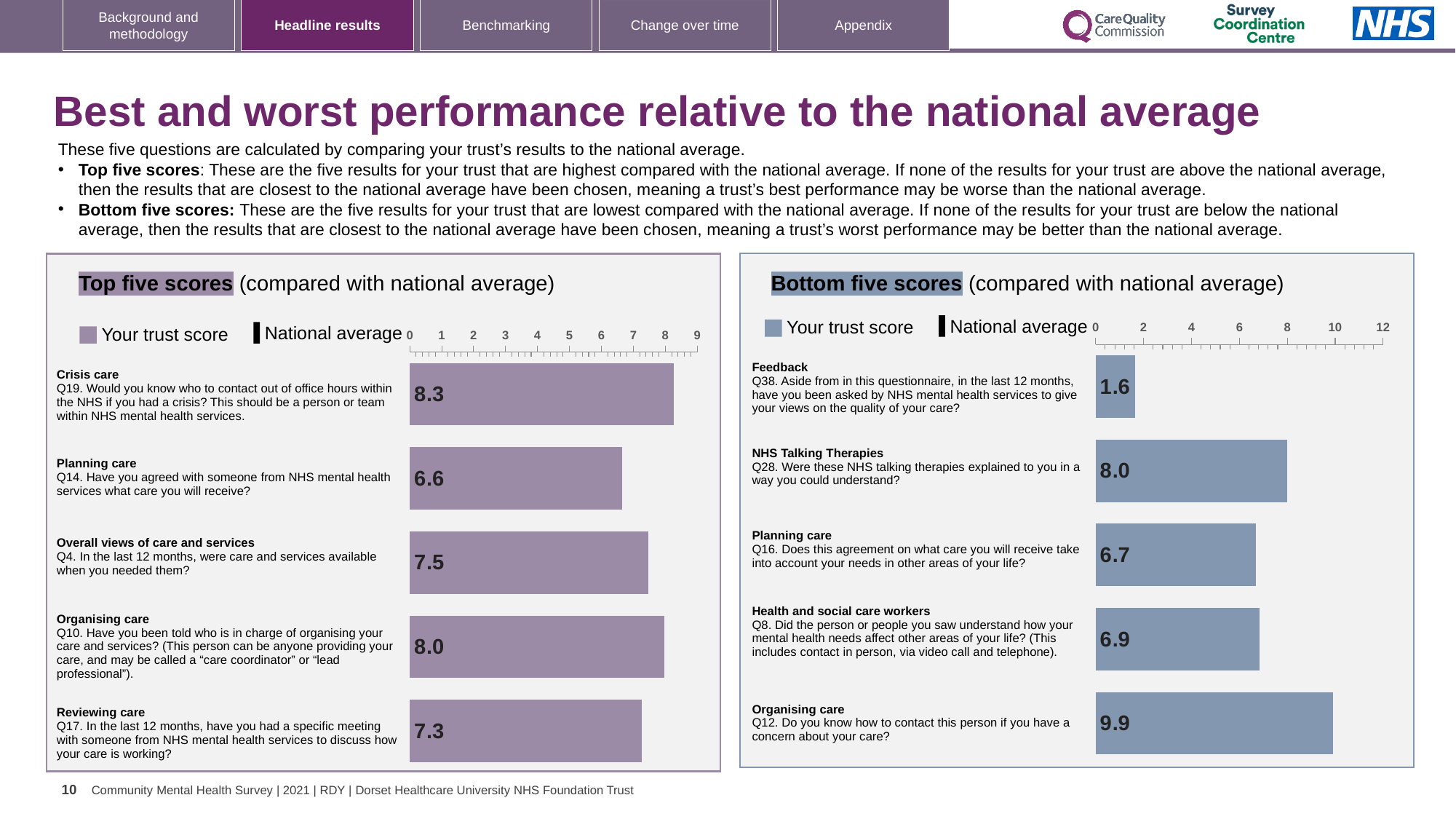
In the Top five scores chart, what is the trust score for Crisis care (Q19)? 8.3 In the Top five scores chart, what is the trust score for Planning care (Q14)? 6.6 What type of chart is the Bottom five scores chart? Bar chart In the Top five scores chart, which question has the lowest trust score? Planning care (Q14) In the Top five scores chart, what is the difference between the trust scores for Crisis care (Q19) and Reviewing care (Q17)? 1.0 In the Top five scores chart, how many questions are plotted? 5 In the Bottom five scores chart, what is the trust score for Feedback (Q38)? 1.6 In the Bottom five scores chart, which is larger: the trust score for Planning care (Q16) or Health and social care workers (Q8)? Health and social care workers (Q8) In the Bottom five scores chart, which question has the highest trust score? Organising care (Q12) How many entries does the legend of the Top five scores chart list? 2 In the Bottom five scores chart, what is the difference between the trust scores for NHS Talking Therapies (Q28) and Feedback (Q38)? 6.4 In the Bottom five scores chart, what is the trust score for Organising care (Q12)? 9.9